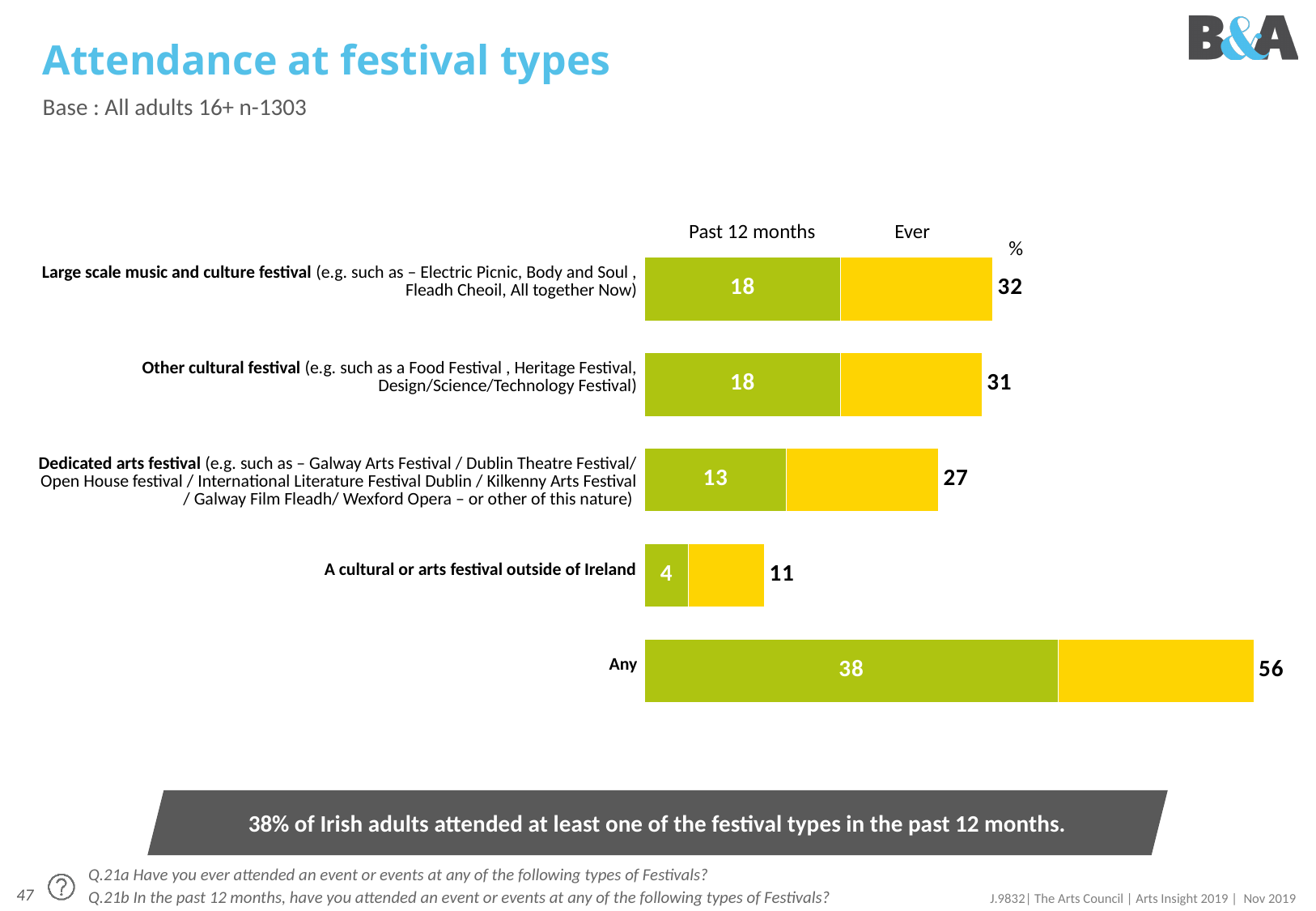
Which category has the lowest 'Past 12 months' value? A cultural or arts festival outside of Ireland What is the 'Ever' value for Dedicated arts festival? 27 What is the difference between the 'Ever' and 'Past 12 months' values for Other cultural festival? 13 What is the 'Ever' value for the 'Any' category? 56 How many festival categories are shown in the chart? 5 Which colour represents the 'Past 12 months' series? Green Which is larger: the 'Ever' value for Large scale music and culture festival or for Dedicated arts festival? Large scale music and culture festival How many series does the chart show? 2 What is the 'Past 12 months' value for a cultural or arts festival outside of Ireland? 4 What percentage attended a large scale music and culture festival in the past 12 months? 18 Which category has the highest 'Ever' value? Any What type of chart is shown on the slide? Bar chart